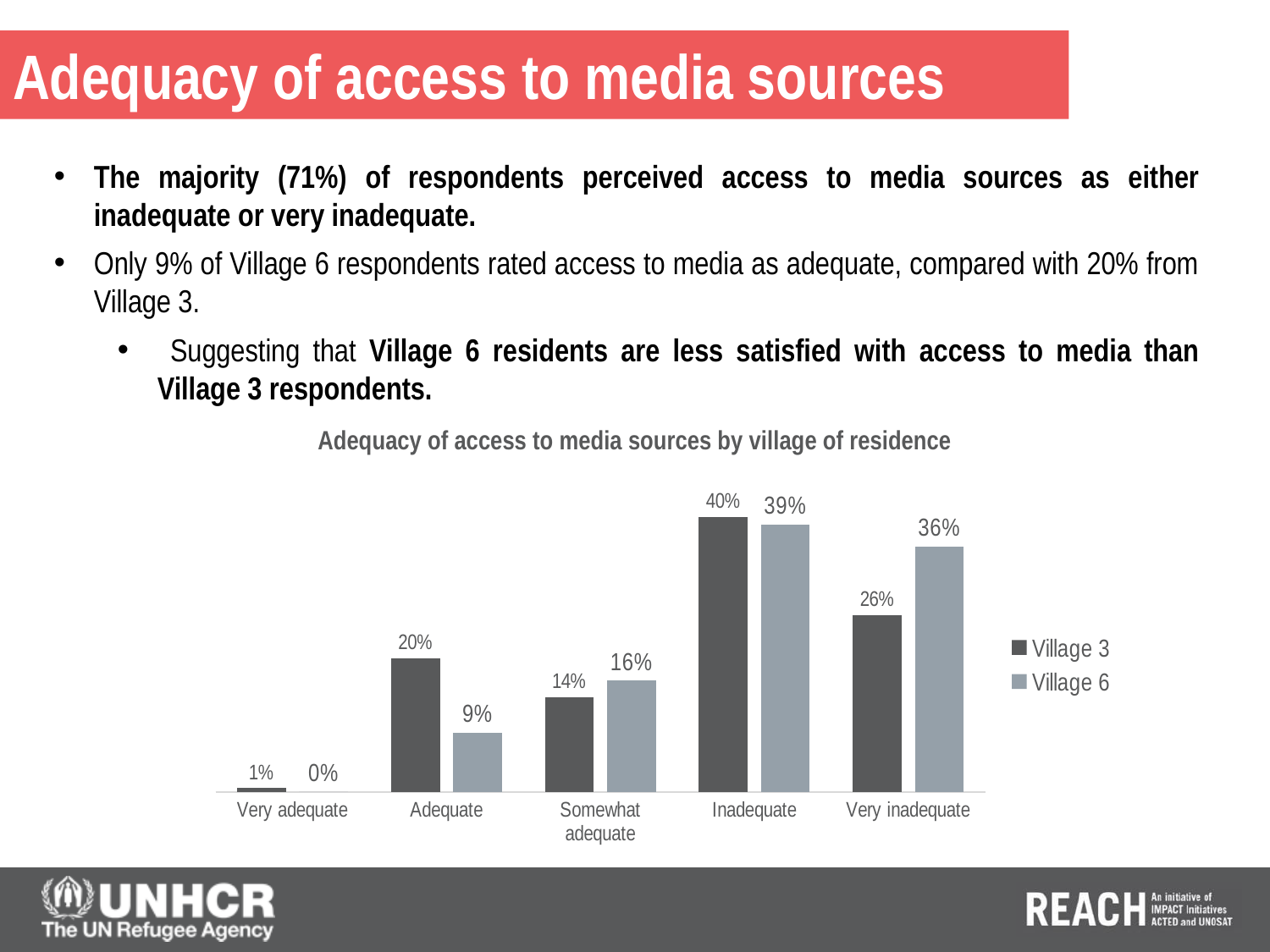
What is the title of the chart? Adequacy of access to media sources by village of residence What is the difference between Village 3 and Village 6 in the Inadequate category? 1% What is the difference between Village 3 and Village 6 in the Adequate category? 11% What is the value for Village 3 in the Adequate category? 20% Which category has the highest value for Village 3? Inadequate How many categories are shown on the x axis? 5 How many series does the legend list? 2 What kind of chart is shown on the slide? Bar chart Which is larger in the Very inadequate category, Village 3 or Village 6? Village 6 What is the value for Village 6 in the Very inadequate category? 36% What is the value for Village 6 in the Somewhat adequate category? 16% Which category has the lowest value for Village 6? Very adequate